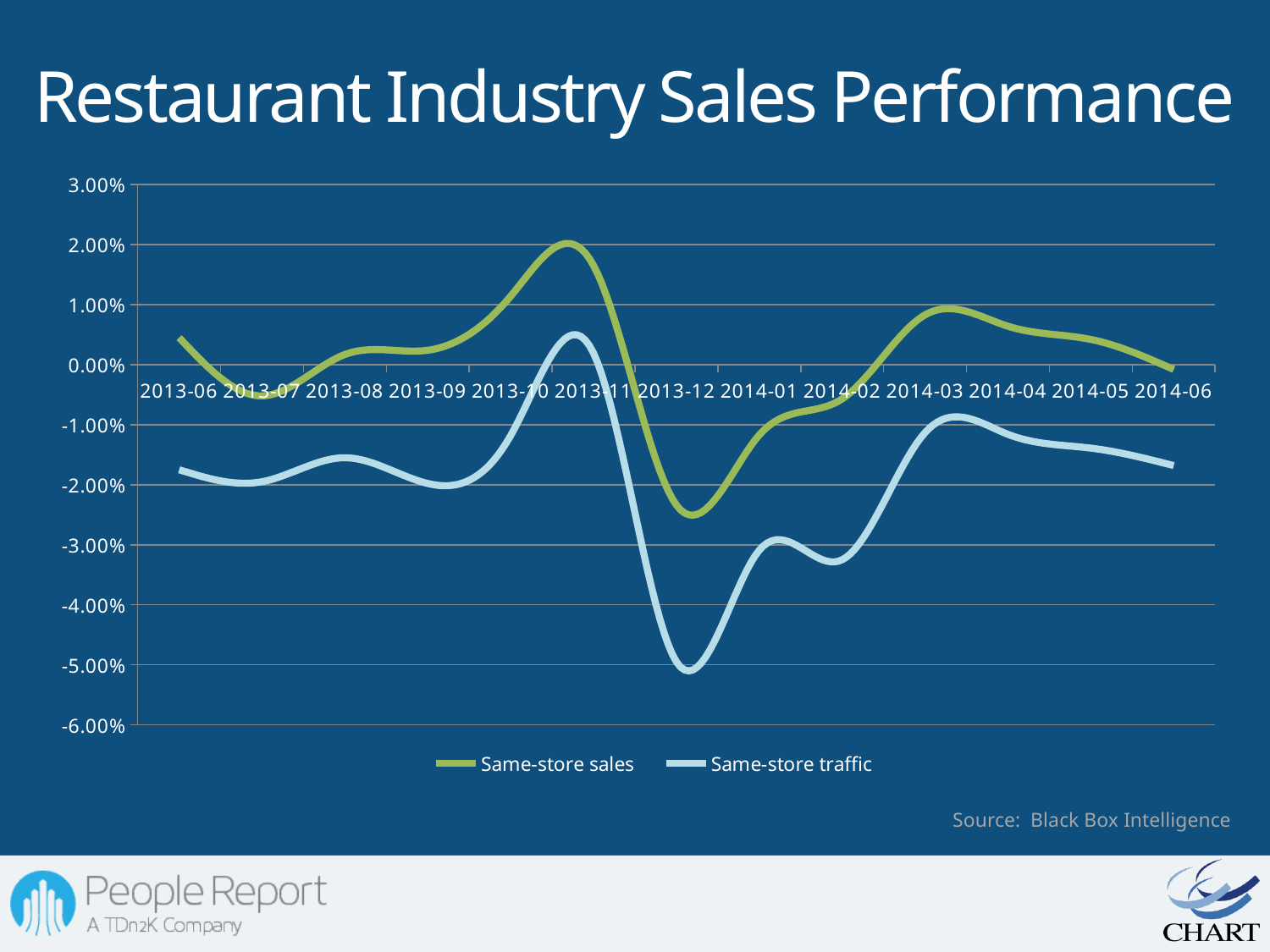
Is the Same-store sales value for 2013-12 greater or less than -2.00%? less What kind of chart is shown on the slide? line chart In which month does Same-store sales reach its highest value? 2013-11 How many series does the legend list? 2 Is the Same-store traffic value for 2013-12 greater or less than -4.00%? less In which month does Same-store traffic reach its highest value? 2013-11 Is the Same-store sales value for 2013-11 greater or less than 1.00%? greater In 2013-12, which series has the higher value, Same-store sales or Same-store traffic? Same-store sales How many months are plotted along the x axis? 13 In which month does Same-store sales reach its lowest value? 2013-12 Does Same-store sales rise or fall from 2014-03 to 2014-06? fall In which month does Same-store traffic reach its lowest value? 2013-12